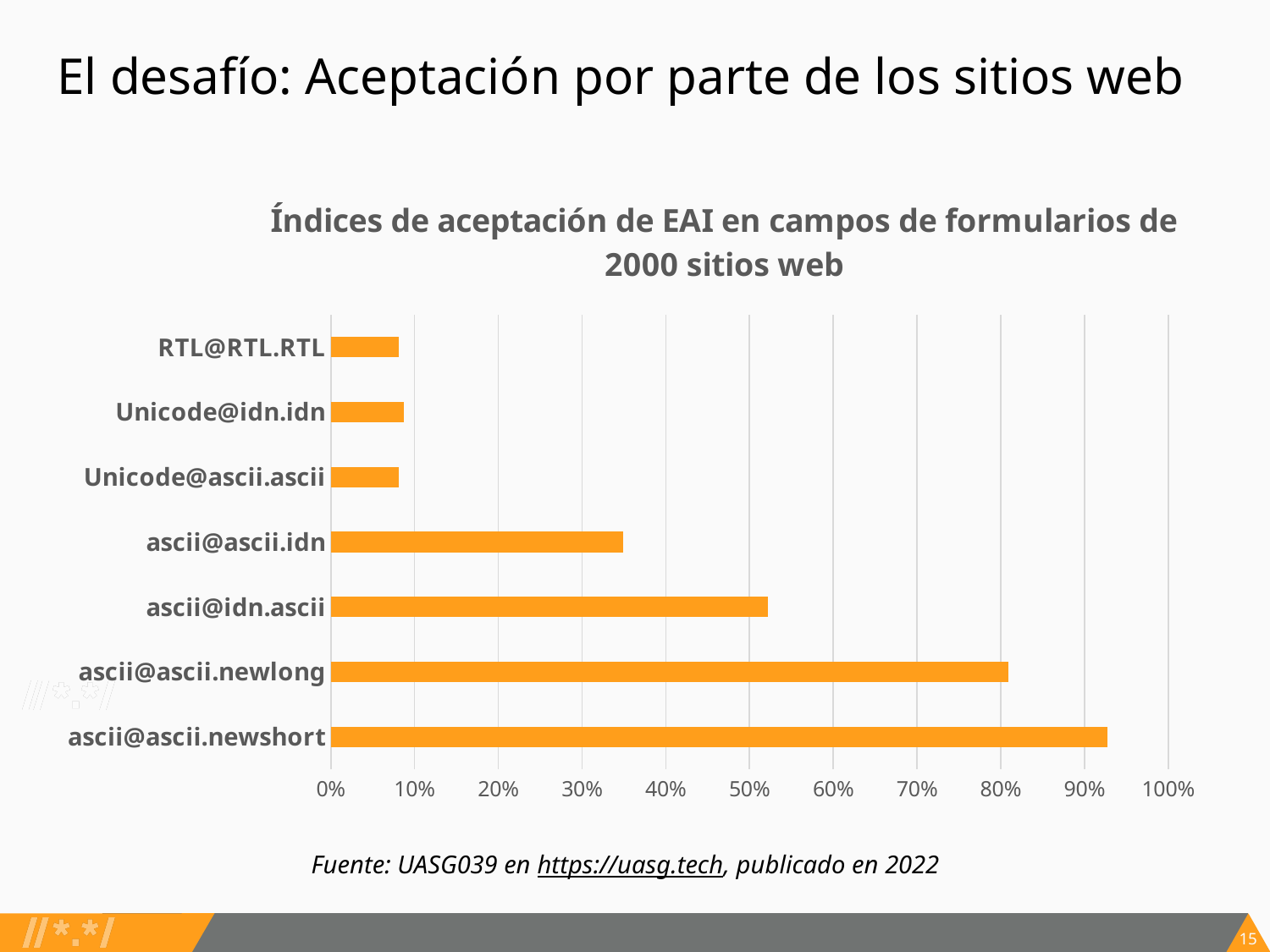
Which is larger, the value for ascii@ascii.idn or the value for Unicode@ascii.ascii? ascii@ascii.idn What is the title of the chart? Índices de aceptación de EAI en campos de formularios de 2000 sitios web Is the value for ascii@ascii.idn greater or less than 40%? less What kind of chart is shown on the slide? bar chart Which category has the highest acceptance rate? ascii@ascii.newshort Is the value for ascii@ascii.newshort greater or less than 90%? greater How many categories are plotted in the chart? 7 Is the value for ascii@idn.ascii greater or less than 50%? greater Which is larger, the value for ascii@ascii.newlong or the value for ascii@idn.ascii? ascii@ascii.newlong